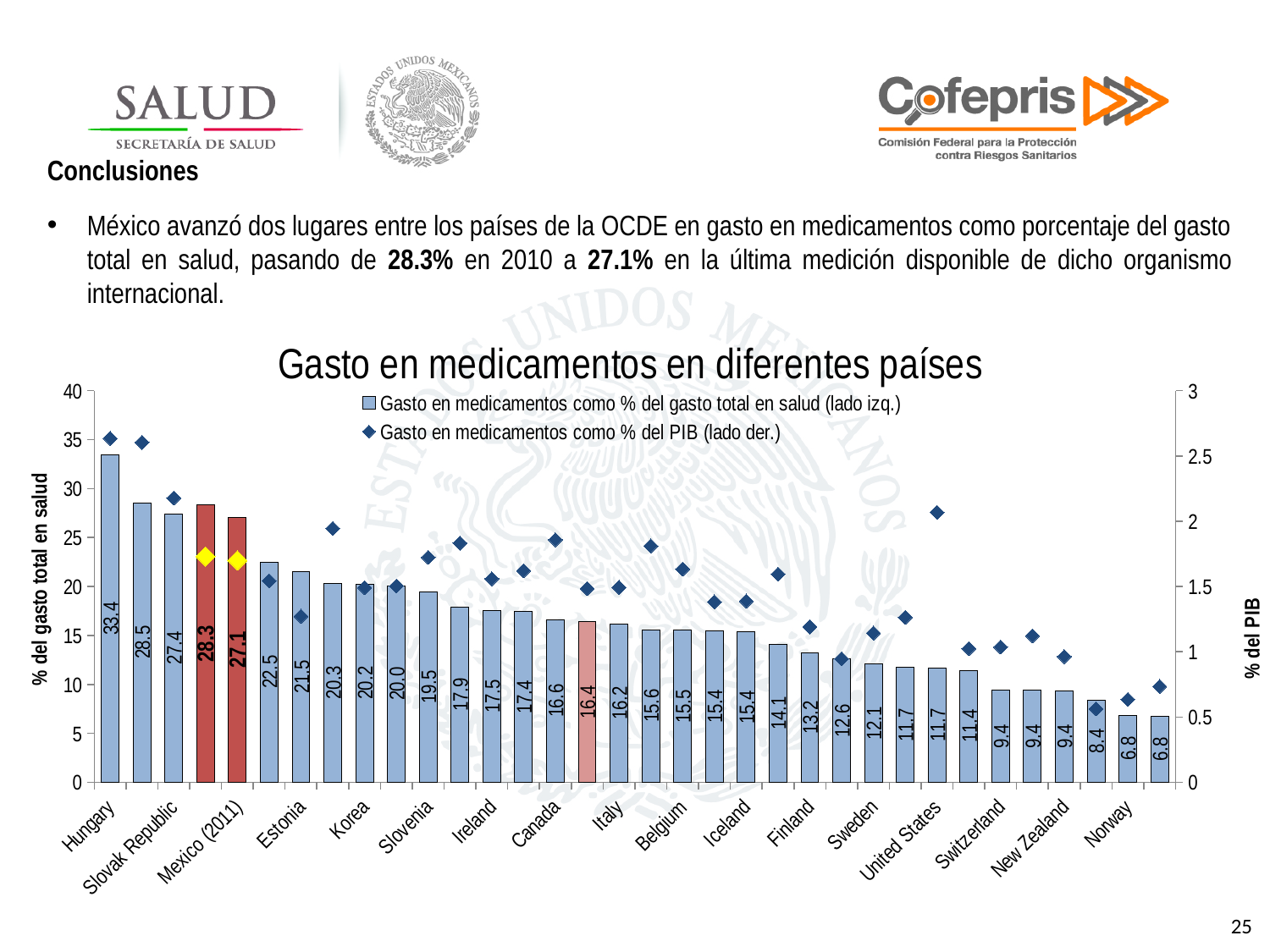
Which has a larger value for 'Gasto en medicamentos como % del gasto total en salud', Hungary or Norway? Hungary Do the bar values rise or fall from left to right along the x axis? fall How many series does the chart legend list? 2 What is the difference between Hungary (33.4) and Mexico (2011) (27.1) in 'Gasto en medicamentos como % del gasto total en salud'? 6.3 What is the value for Hungary for 'Gasto en medicamentos como % del gasto total en salud'? 33.4 What kind of chart is used to show 'Gasto en medicamentos como % del gasto total en salud'? bar chart What is the lowest value shown for 'Gasto en medicamentos como % del gasto total en salud'? 6.8 What is the title of the chart? Gasto en medicamentos en diferentes países What colour are the bars for Mexico in the chart? red Which country has the highest value for 'Gasto en medicamentos como % del gasto total en salud'? Hungary What is the value for Mexico (2011) for 'Gasto en medicamentos como % del gasto total en salud'? 27.1 Is the 'Gasto en medicamentos como % del PIB' value for Hungary greater or less than 2.5? greater